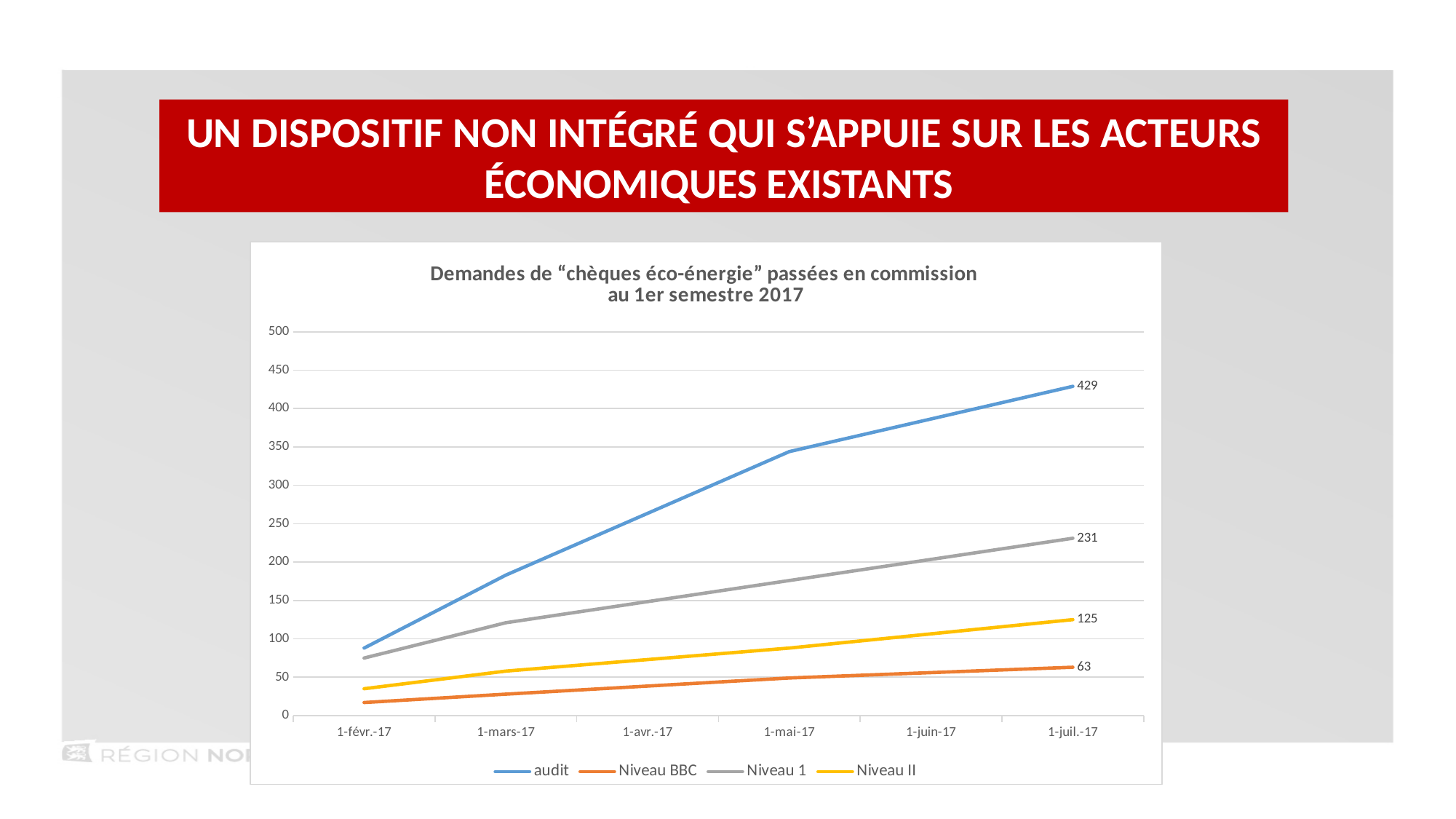
How many series does the legend list? 4 What kind of chart is shown on the slide? line chart How many dates are shown on the x axis? 6 What is the value for Niveau II at 1-juil.-17? 125 What is the value for Niveau BBC at 1-juil.-17? 63 What is the value for the audit series at 1-juil.-17? 429 At 1-juil.-17, which is larger: Niveau II or Niveau BBC? Niveau II Which series has the lowest value at 1-juil.-17? Niveau BBC What is the difference between the audit value and the Niveau 1 value at 1-juil.-17? 198 What is the value for Niveau 1 at 1-juil.-17? 231 Is the value for the audit series at 1-mai-17 greater or less than 300? greater Which series has the highest value at 1-juil.-17? audit